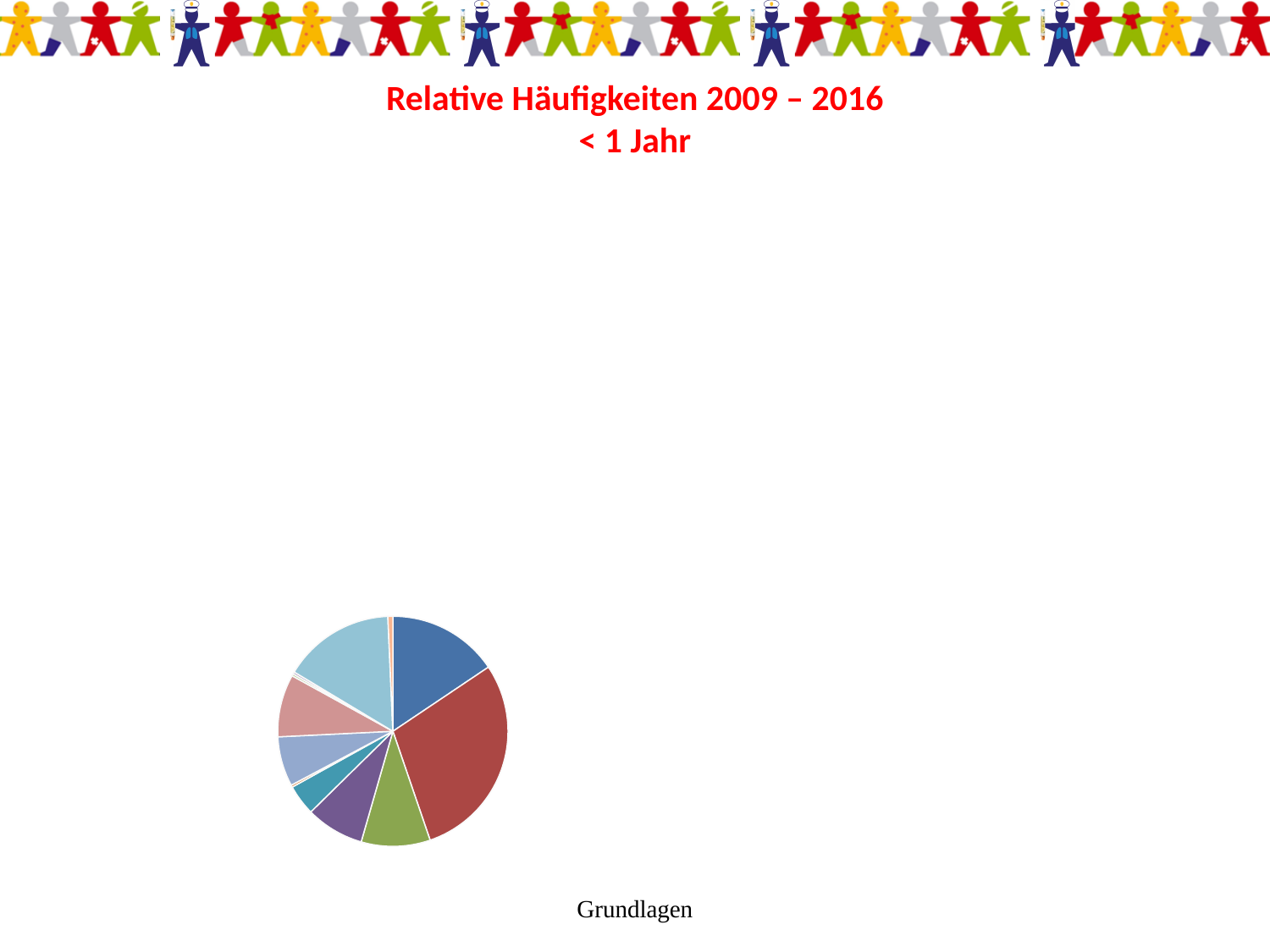
What is the title shown above the pie chart? Relative Häufigkeiten 2009 – 2016 < 1 Jahr Does the pie chart have a legend? no Is the green slice of the pie chart larger or smaller than the teal slice? larger Is the red slice of the pie chart larger or smaller than the dark blue slice? larger What kind of chart is shown on the slide? pie chart Which colour slice is the largest in the pie chart? red